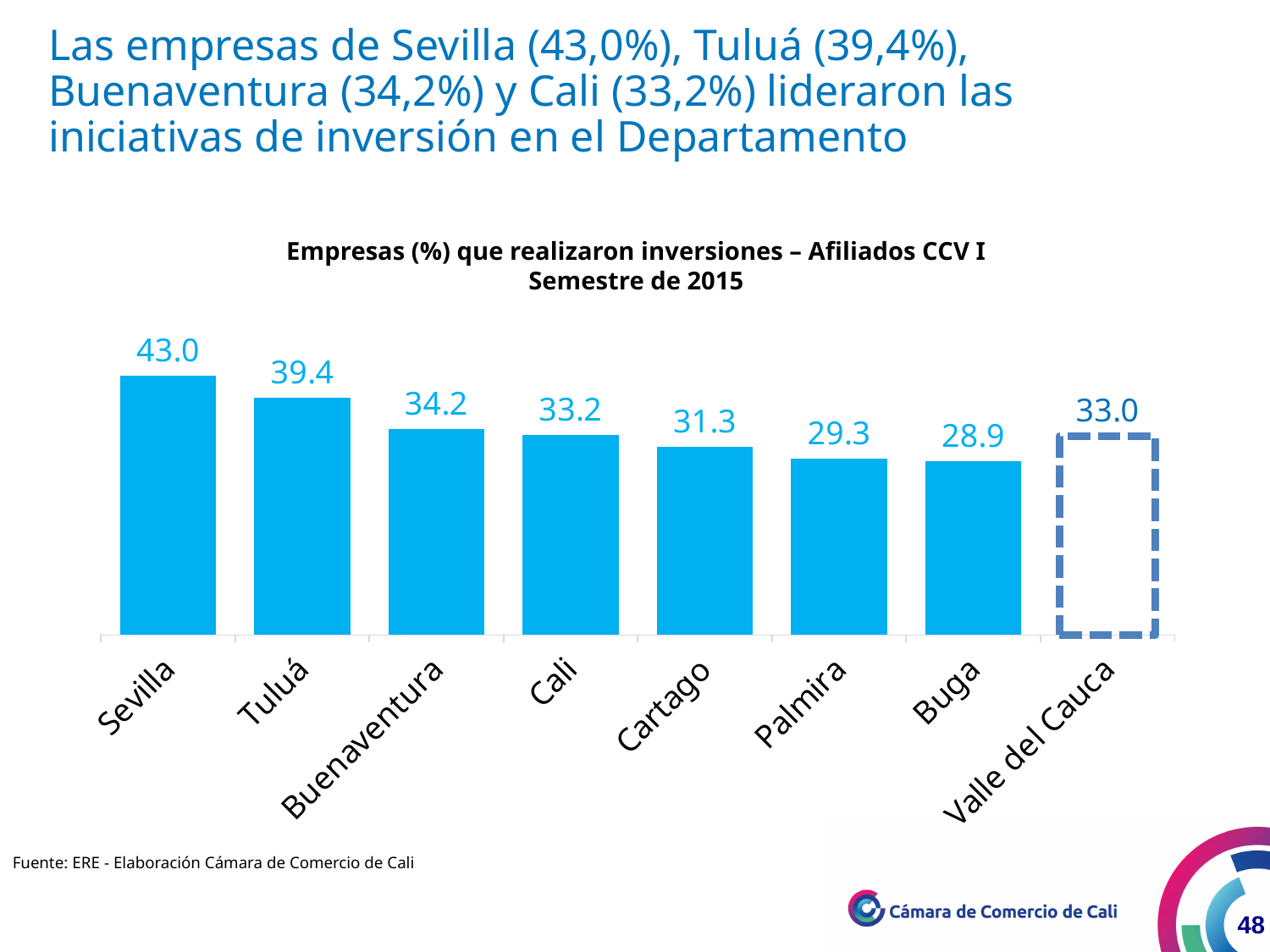
Which is larger, the value for Buenaventura or the value for Palmira? Buenaventura What is the value for Valle del Cauca? 33.0 Which is larger, the value for Valle del Cauca or the value for Cartago? Valle del Cauca What is the value for Sevilla? 43.0 Which bar is drawn with a dashed outline instead of a solid fill? Valle del Cauca What kind of chart is this? Bar chart How many categories are shown on the x axis? 8 Which category has the lowest value? Buga What is the value for Cartago? 31.3 What is the difference between the values for Sevilla and Tuluá? 3.6 Which category has the highest value? Sevilla What is the difference between the values for Cali and Buga? 4.3